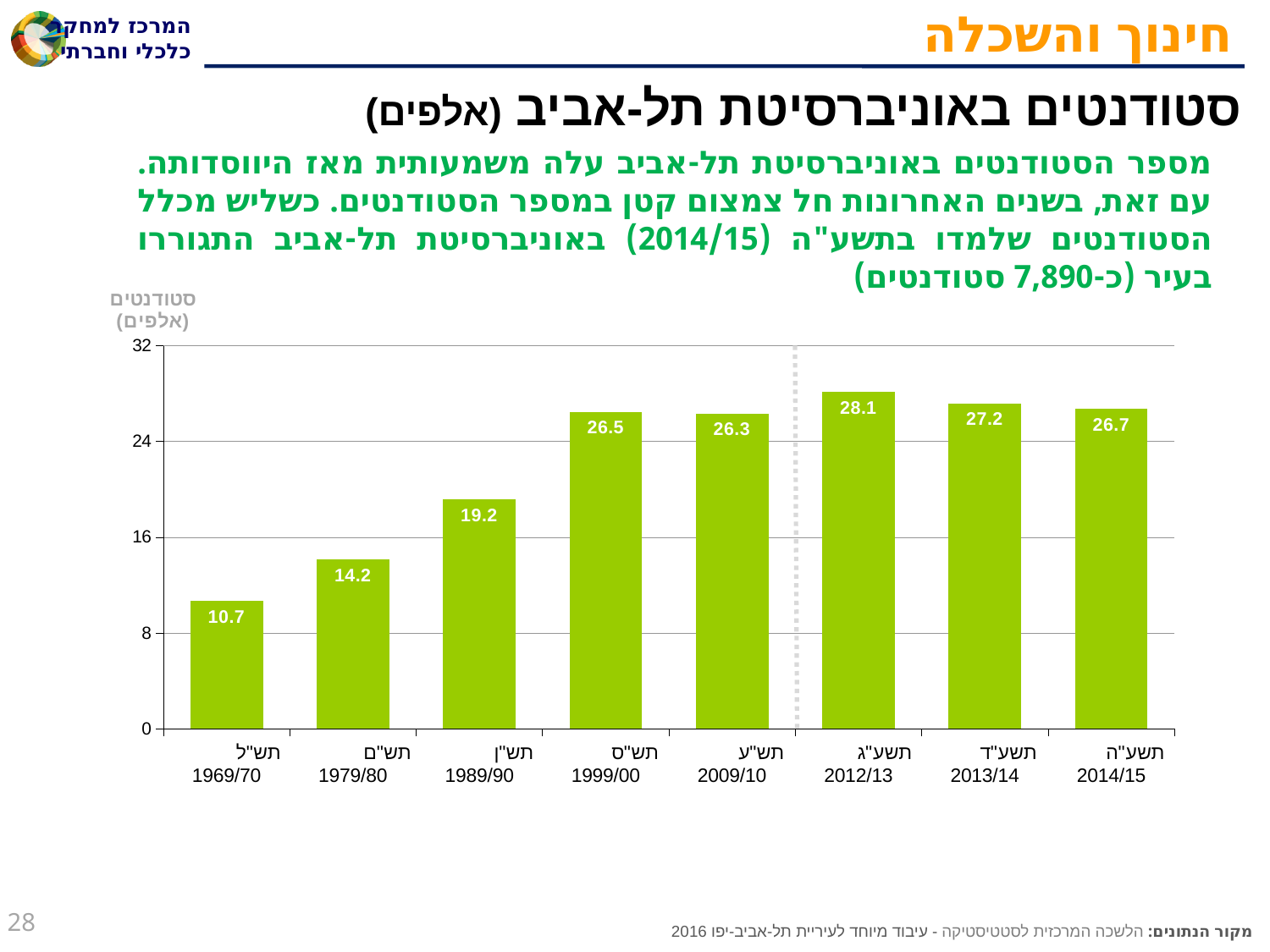
Is the value for 1989/90 greater or less than 16? greater Which is larger, the value for 1999/00 or the value for 2009/10? 1999/00 Which year has the highest value? 2012/13 What kind of chart is shown on the slide? Bar chart What is the value for 2012/13? 28.1 How many bars are shown in the chart? 8 Do the values rise or fall from 1969/70 to 1999/00? Rise What is the difference between the values for 1989/90 and 1979/80? 5 Which year has the lowest value? 1969/70 What is the value for 1969/70? 10.7 What is the value for 2014/15? 26.7 What is the difference between the values for 2012/13 and 2014/15? 1.4